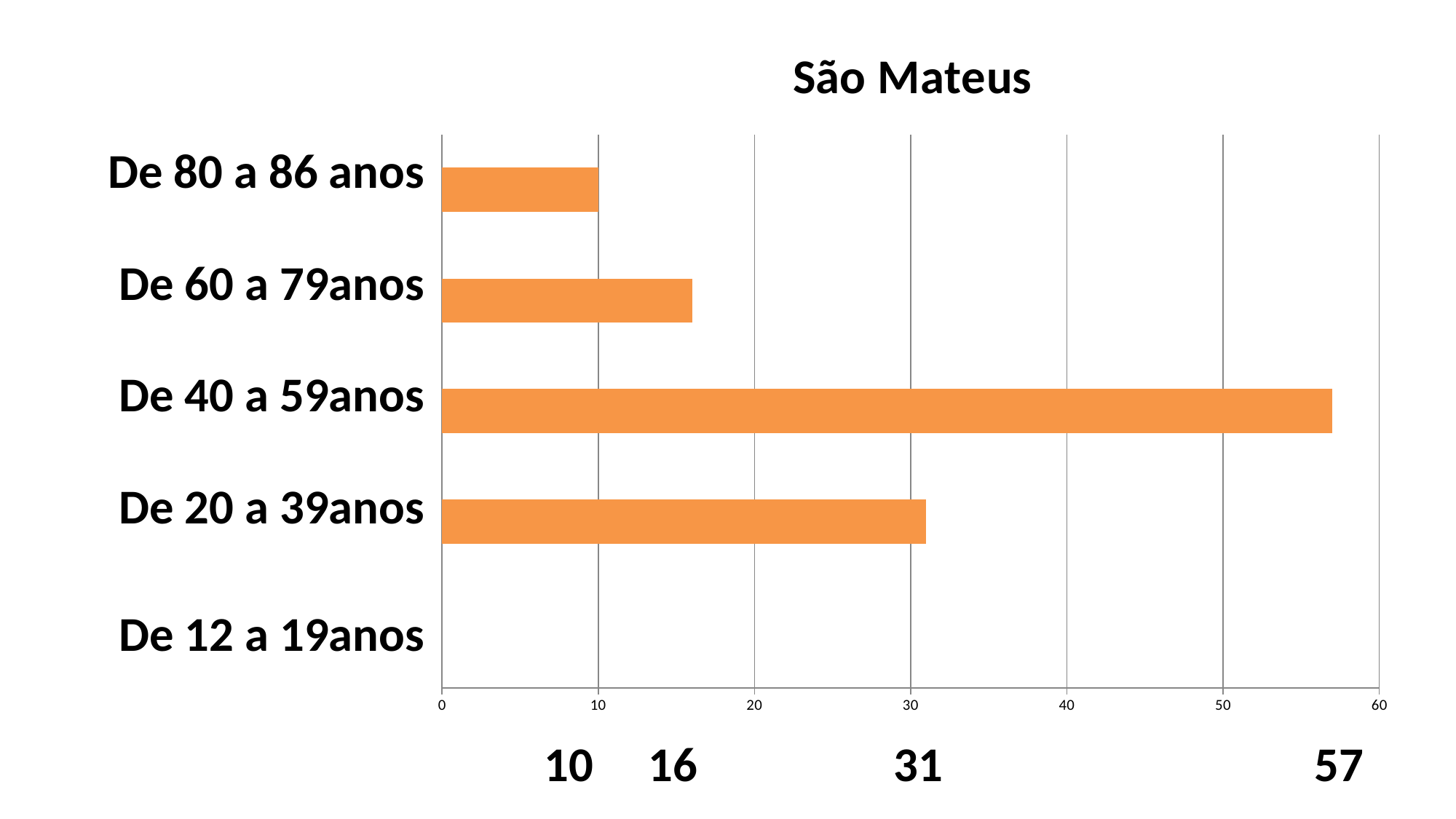
What is the value for De 40 a 59anos? 57 What is the value for De 80 a 86 anos? 10 What is the difference between the values for De 40 a 59anos and De 20 a 39anos? 26 What kind of chart is shown on the slide? bar chart How many age groups are shown on the chart? 5 What is the value for De 60 a 79anos? 16 Which age group has the highest value? De 40 a 59anos What is the value for De 20 a 39anos? 31 What is the title of the chart? São Mateus Is the value for De 20 a 39anos greater or less than 30? greater Which is larger, the value for De 60 a 79anos or De 80 a 86 anos? De 60 a 79anos